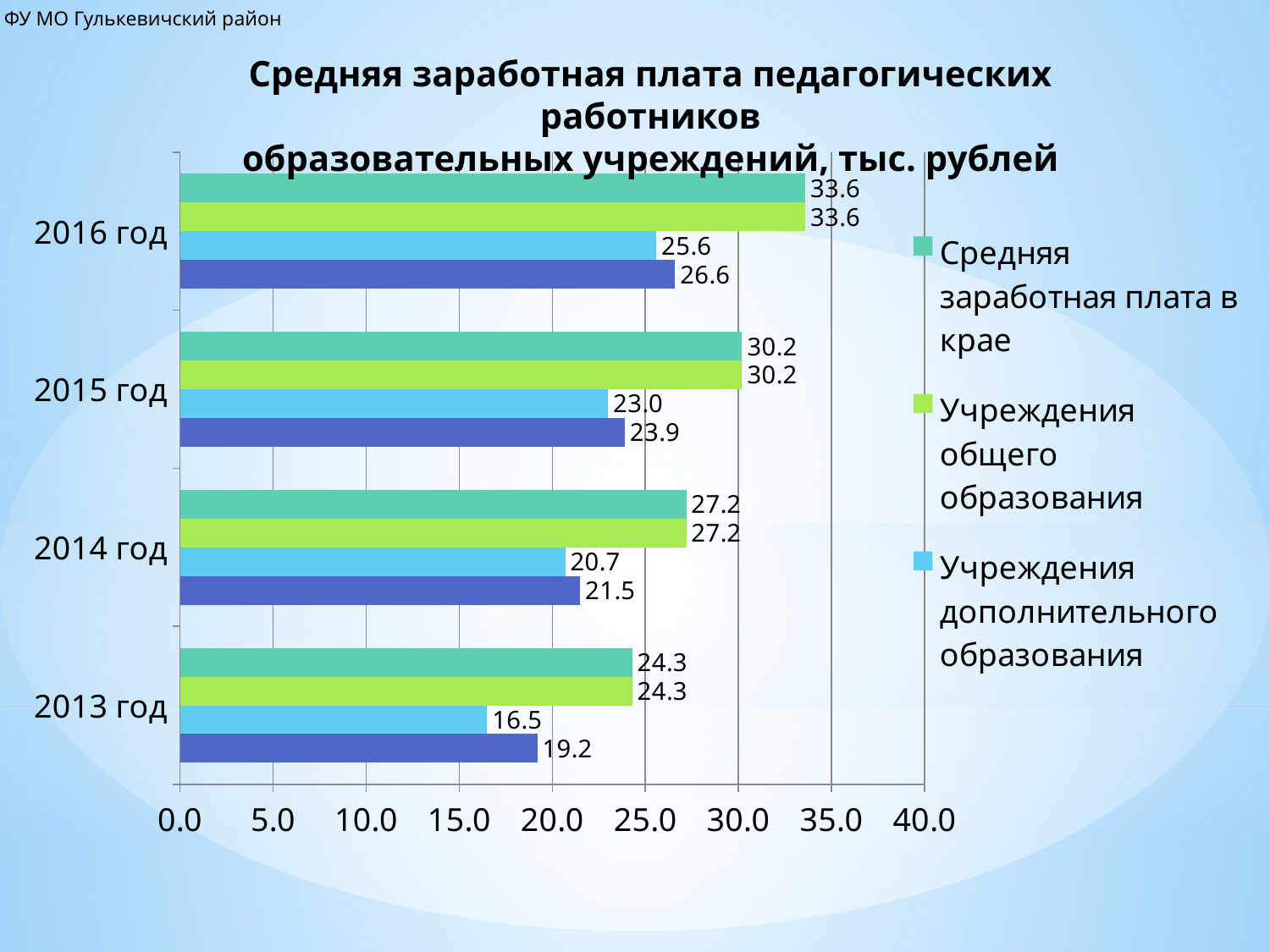
Which is larger: Учреждения дополнительного образования in 2015 год or Учреждения общего образования in 2014 год? Учреждения общего образования in 2014 год What is the value for Средняя заработная плата в крае in 2016 год? 33.6 In 2014 год, how much higher is Средняя заработная плата в крае than Учреждения дополнительного образования? 6.5 What is the difference between the 2016 год and 2013 год values for Учреждения общего образования? 9.3 How many years are shown on the chart? 4 Do the values for Учреждения дополнительного образования rise or fall from 2013 год to 2016 год? Rise What kind of chart is shown on the slide? Bar chart What is the value for Учреждения дополнительного образования in 2013 год? 16.5 What unit is stated in the chart title? тыс. рублей In which year is the value for Учреждения дополнительного образования the highest? 2016 год What is the value for Учреждения общего образования in 2015 год? 30.2 In which year is the value for Средняя заработная плата в крае the lowest? 2013 год